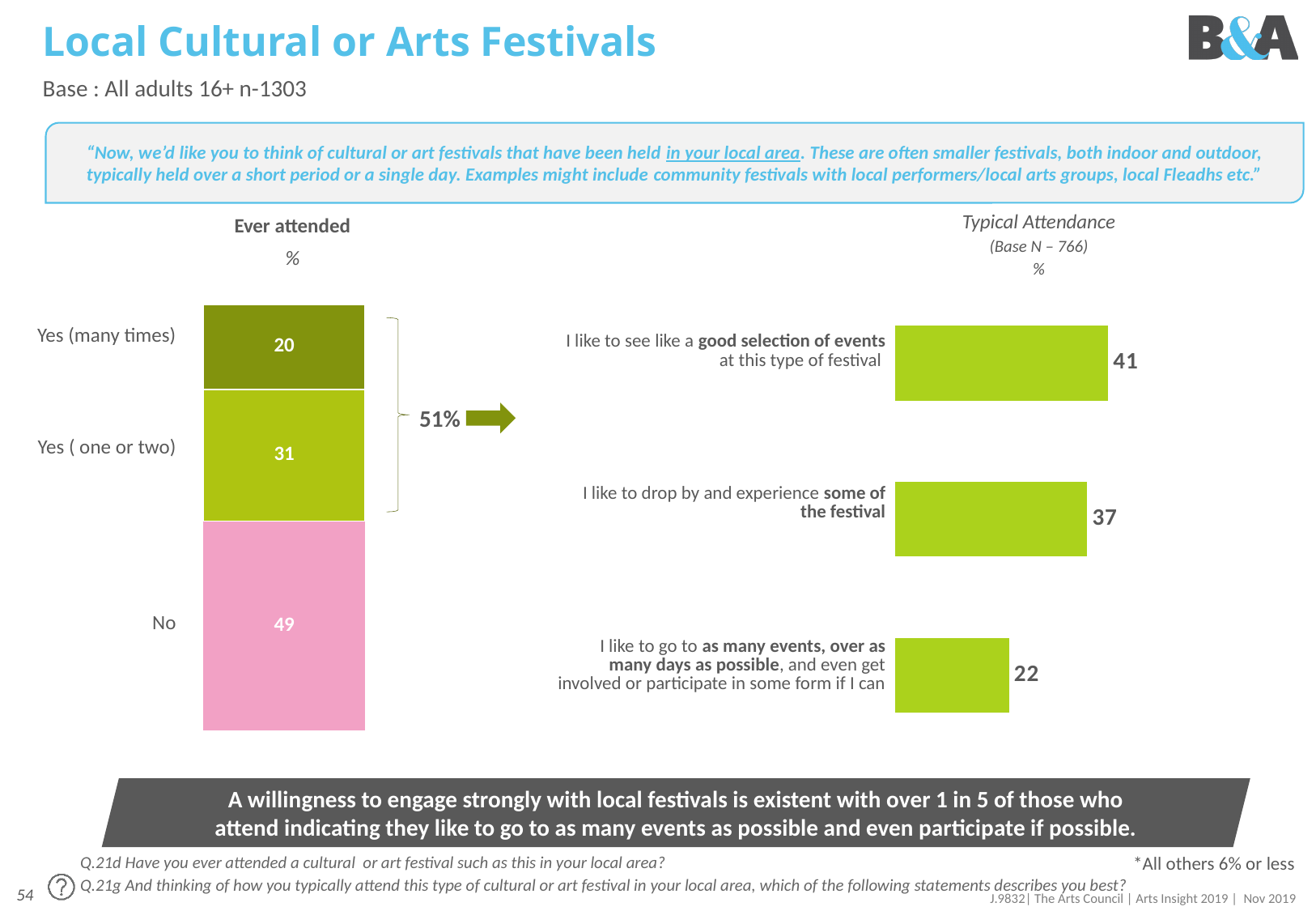
In the 'Typical Attendance' chart, what is the difference between the highest and lowest values? 19 In the 'Ever attended' chart, which category has the highest value? No In the 'Ever attended' chart, which category has the lowest value? Yes (many times) What kind of chart is the 'Typical Attendance' chart? Bar chart In the 'Ever attended' chart, what is the value for 'No'? 49 In the 'Ever attended' chart, what is the difference between 'No' and 'Yes ( one or two)'? 18 How many statements are shown in the 'Typical Attendance' chart? 3 In the 'Typical Attendance' chart, which statement has the highest value? I like to see like a good selection of events at this type of festival In the 'Ever attended' chart, what is the combined value of the two 'Yes' segments shown by the bracket? 51% In the 'Typical Attendance' chart, what is the value for 'I like to go to as many events, over as many days as possible, and even get involved or participate in some form if I can'? 22 In the 'Ever attended' chart, what is the value for 'Yes (many times)'? 20 In the 'Typical Attendance' chart, what is the value for 'I like to drop by and experience some of the festival'? 37